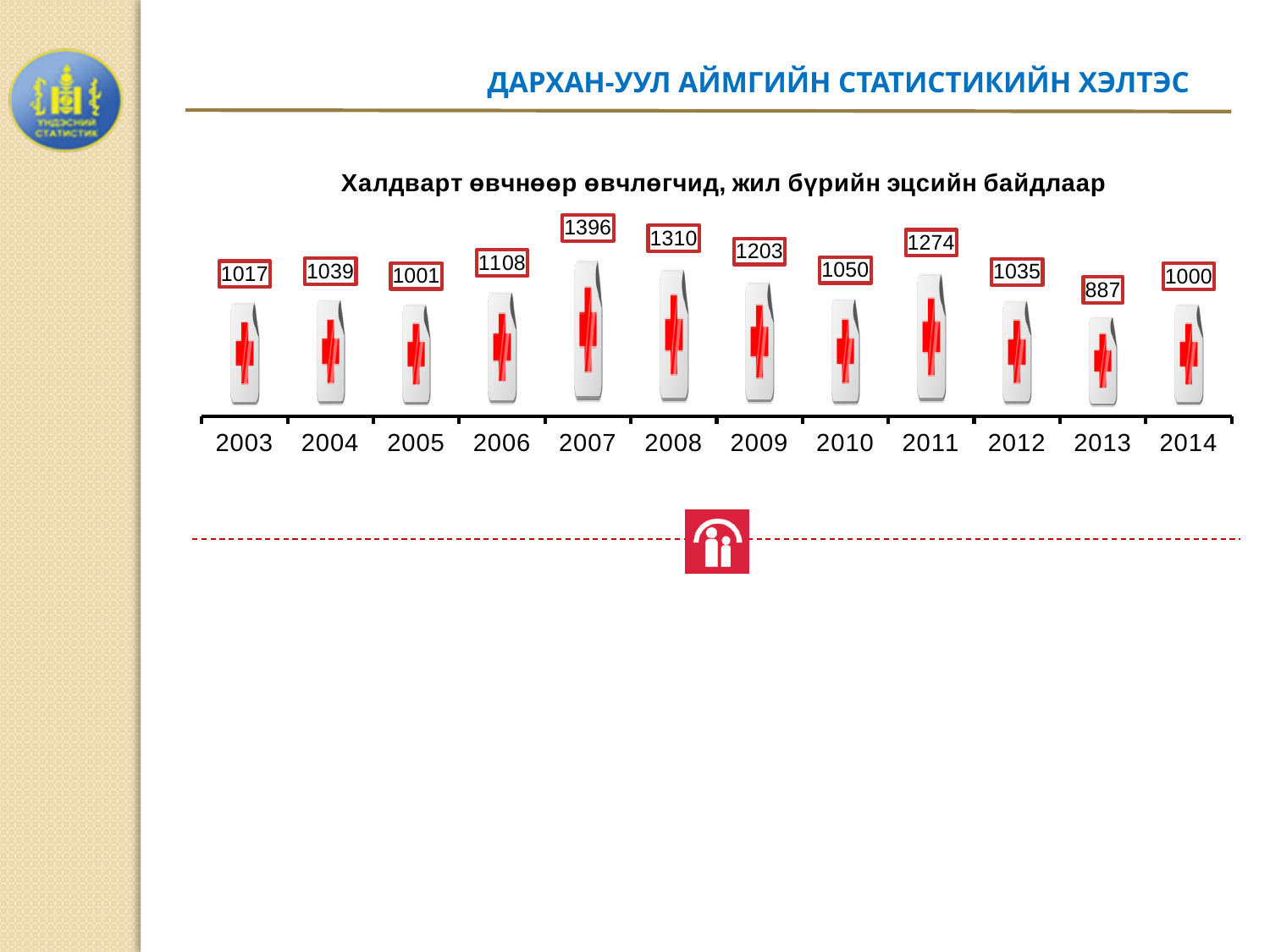
What is the value shown for 2011? 1274 What kind of chart is this? bar chart What is the title of the chart? Халдварт өвчнөөр өвчлөгчид, жил бүрийн эцсийн байдлаар Which is larger, the value for 2009 or the value for 2011? 2011 What is the value shown for 2007? 1396 What is the value shown for 2003? 1017 What is the difference between the values for 2007 and 2008? 86 Which year has the lowest value? 2013 Which year has the highest value? 2007 What is the value shown for 2013? 887 How many years are shown on the x axis? 12 What is the difference between the values for 2014 and 2013? 113